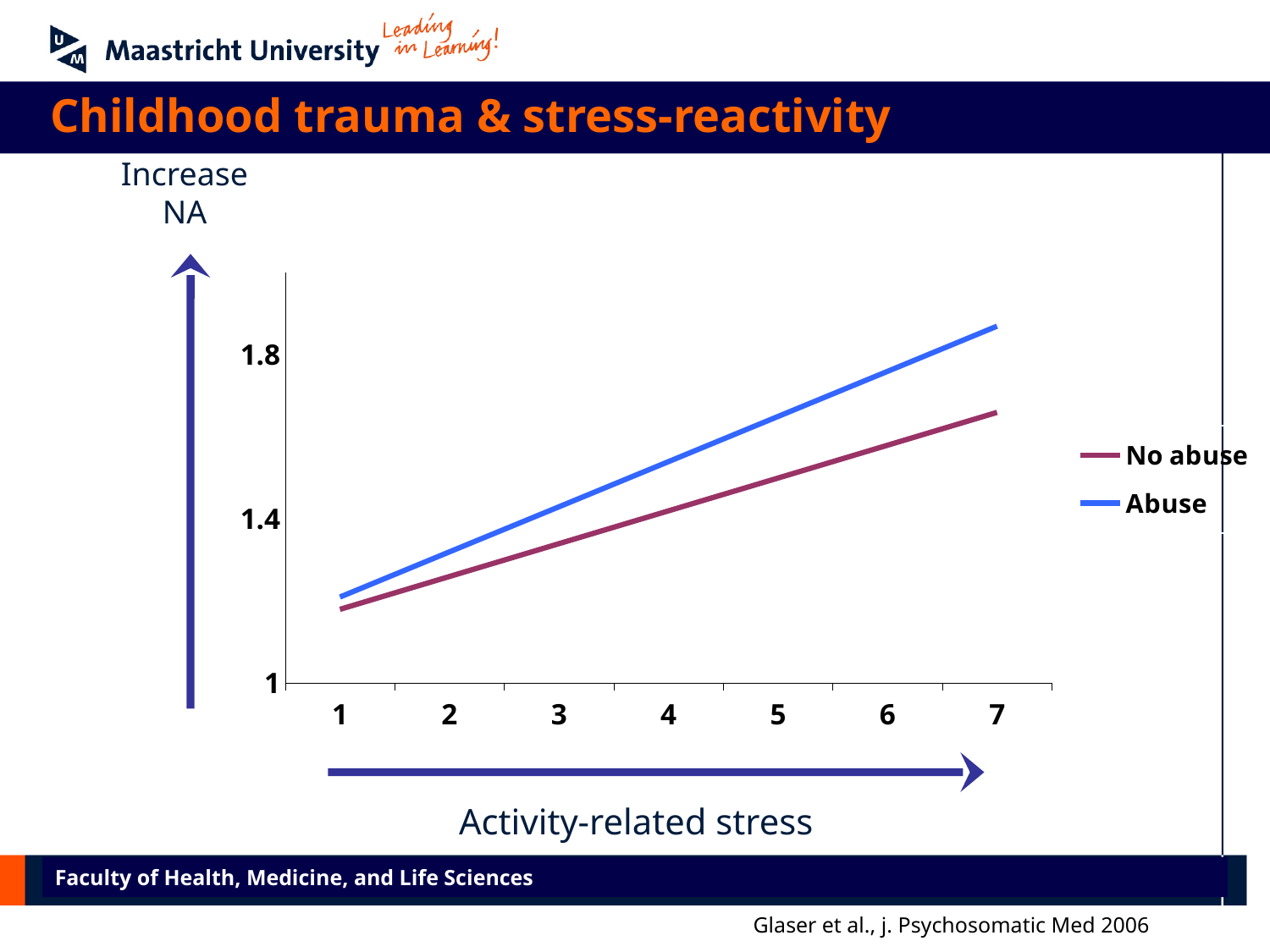
How many series does the legend list? 2 At activity-related stress level 7, which series has the higher value, Abuse or No abuse? Abuse How many activity-related stress levels are marked on the x axis? 7 Is the value for the Abuse series at stress level 1 greater or less than 1.4? less Is the value for the No abuse series at stress level 7 greater or less than 1.8? less Is the value for the Abuse series at stress level 7 greater or less than 1.8? greater What are the two series named in the legend? No abuse and Abuse Do the values for the Abuse series rise or fall as activity-related stress increases from 1 to 7? rise What kind of chart is shown on the slide? line chart Do the values for the No abuse series rise or fall along the x axis? rise Which series is drawn in blue? Abuse